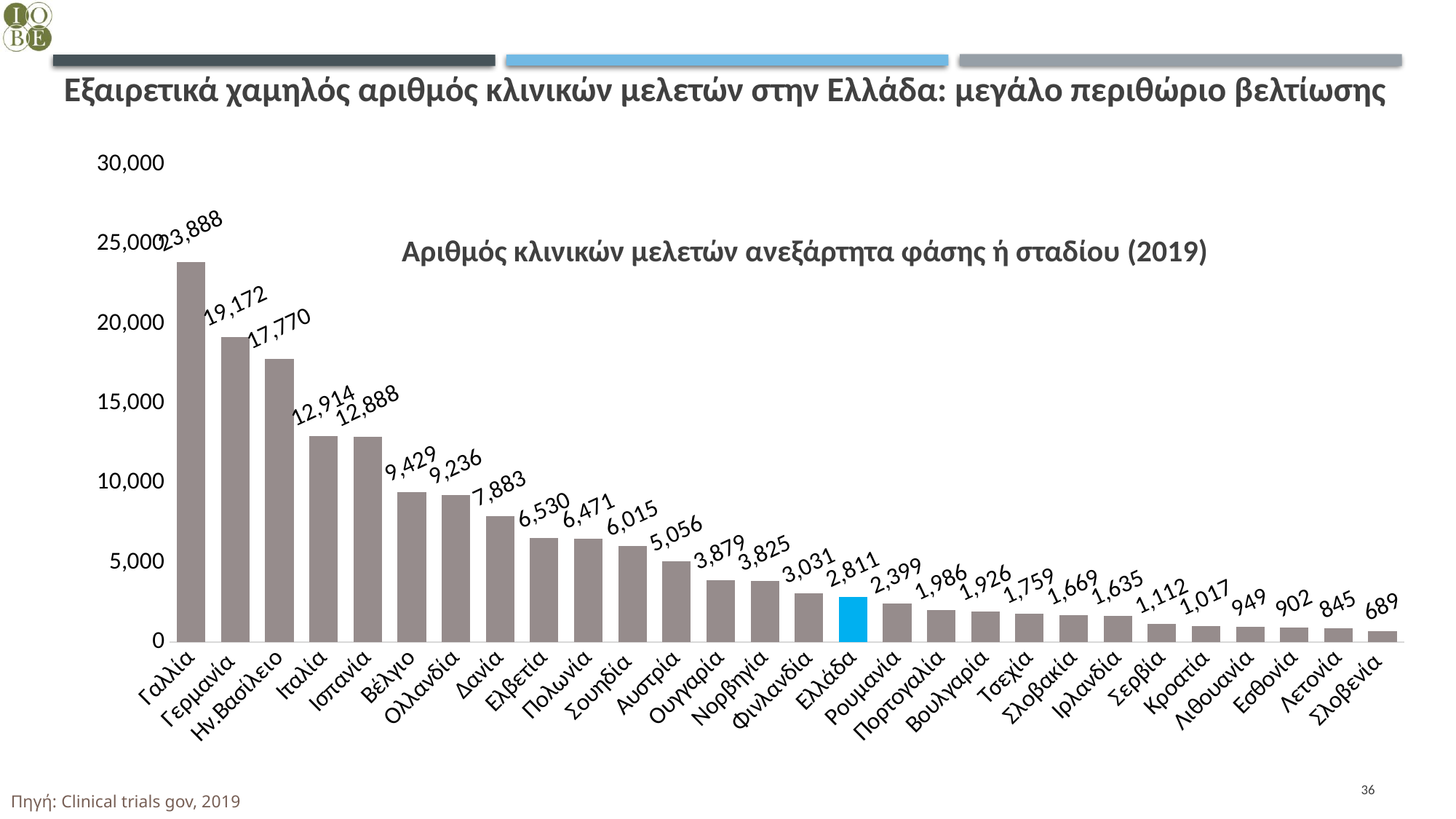
What is the value for Ελλάδα? 2,811 What is the difference between the values for Ελλάδα and Ρουμανία? 412 What is the value for Πολωνία? 6,471 Is the value for Ην.Βασίλειο greater or less than 15,000? greater Which country has the lowest number of clinical trials? Σλοβενία What is the difference between the values for Γαλλία and Γερμανία? 4,716 What is the value for Γερμανία? 19,172 How many countries are shown in the chart? 28 Which country's bar is highlighted in blue? Ελλάδα What kind of chart is shown on the slide? bar chart Which is larger, the value for Βέλγιο or the value for Δανία? Βέλγιο Which country has the highest number of clinical trials? Γαλλία